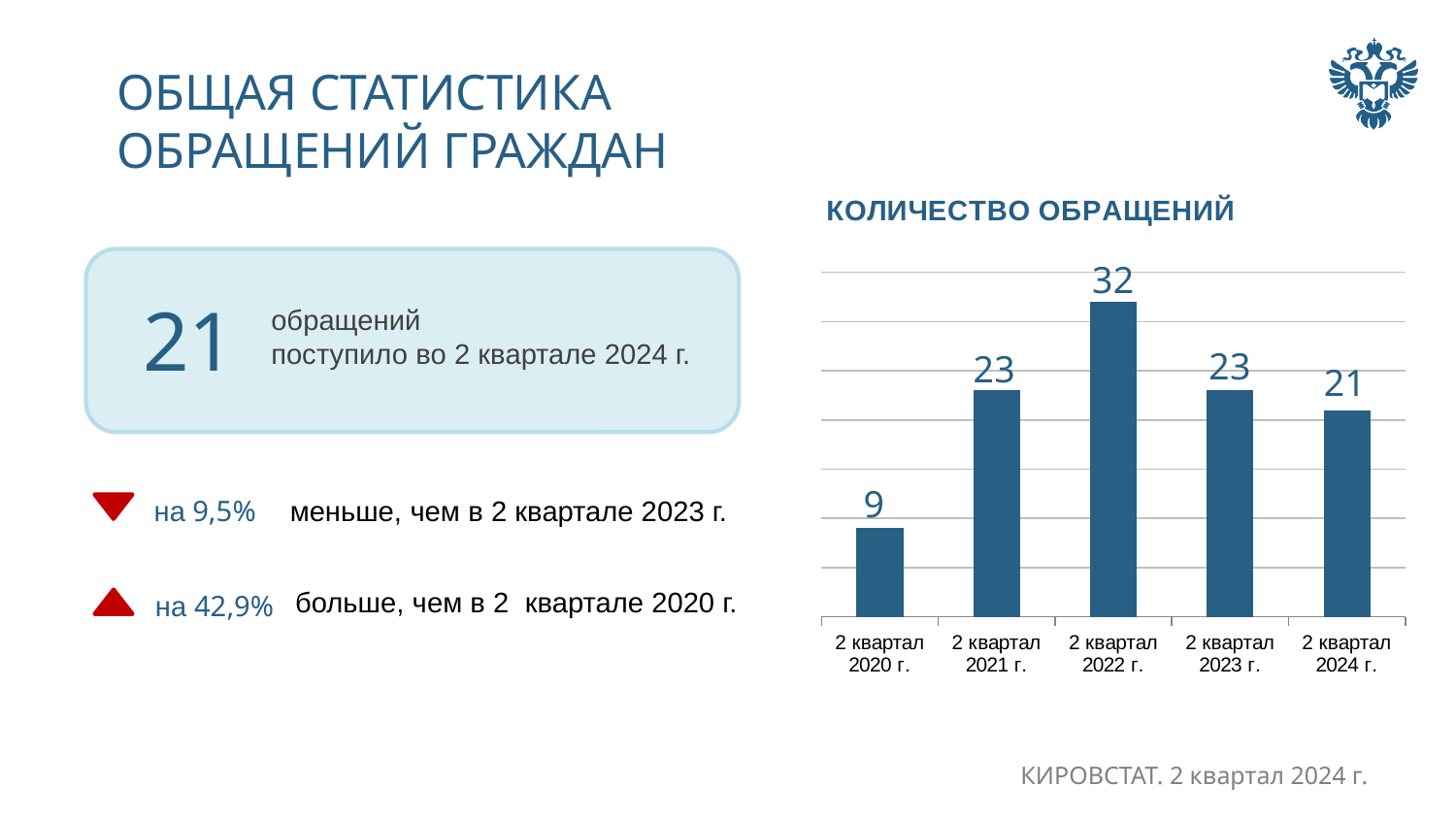
What is the value for 2 квартал 2024 г.? 21 What kind of chart is shown? bar chart Which category has the lowest value? 2 квартал 2020 г. What is the difference between the values for 2 квартал 2021 г. and 2 квартал 2020 г.? 14 What is the value for 2 квартал 2020 г.? 9 Which is larger, the value for 2 квартал 2023 г. or 2 квартал 2024 г.? 2 квартал 2023 г. Which category has the highest value? 2 квартал 2022 г. What is the difference between the values for 2 квартал 2022 г. and 2 квартал 2024 г.? 11 Do the values rise or fall from 2 квартал 2022 г. to 2 квартал 2024 г.? fall What is the title of the chart? КОЛИЧЕСТВО ОБРАЩЕНИЙ How many categories are shown on the x axis? 5 What is the value for 2 квартал 2022 г.? 32